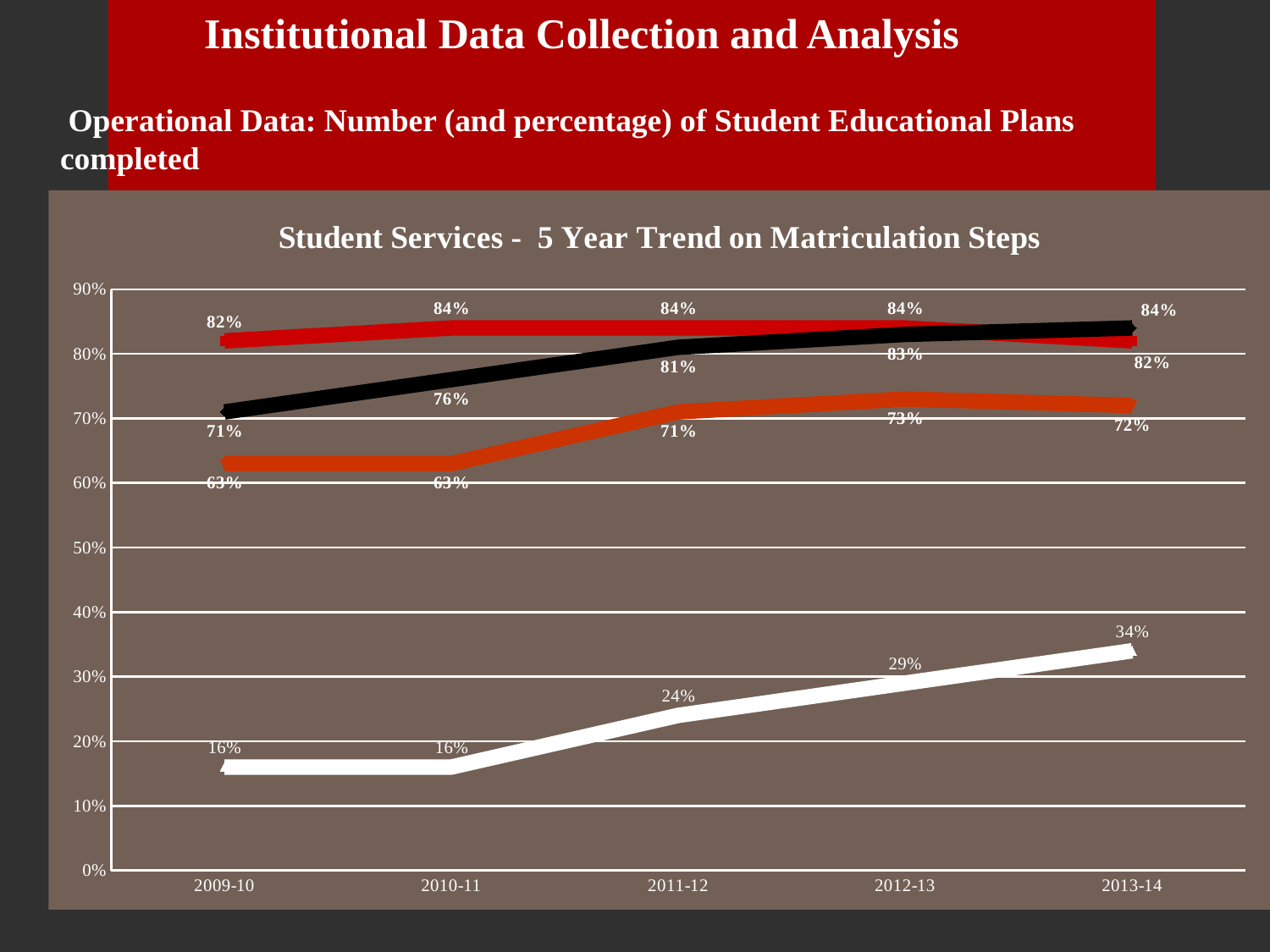
Does the white line rise or fall from 2009-10 to 2013-14? rise What is the difference between the white line's value in 2013-14 and its value in 2009-10? 18% Is the value of the white line in 2012-13 greater or less than 20%? greater How many years are shown along the x axis of the chart? 5 What is the value of the white line in 2011-12? 24% What is the value of the black line in 2009-10? 71% What is the value of the white line in 2013-14? 34% Which is larger in 2009-10: the value of the black line or the value of the white line? the black line In which year is the white line at its highest value? 2013-14 What is the title of the chart? Student Services - 5 Year Trend on Matriculation Steps In which year is the black line at its lowest value? 2009-10 What kind of chart is shown on the slide? line chart